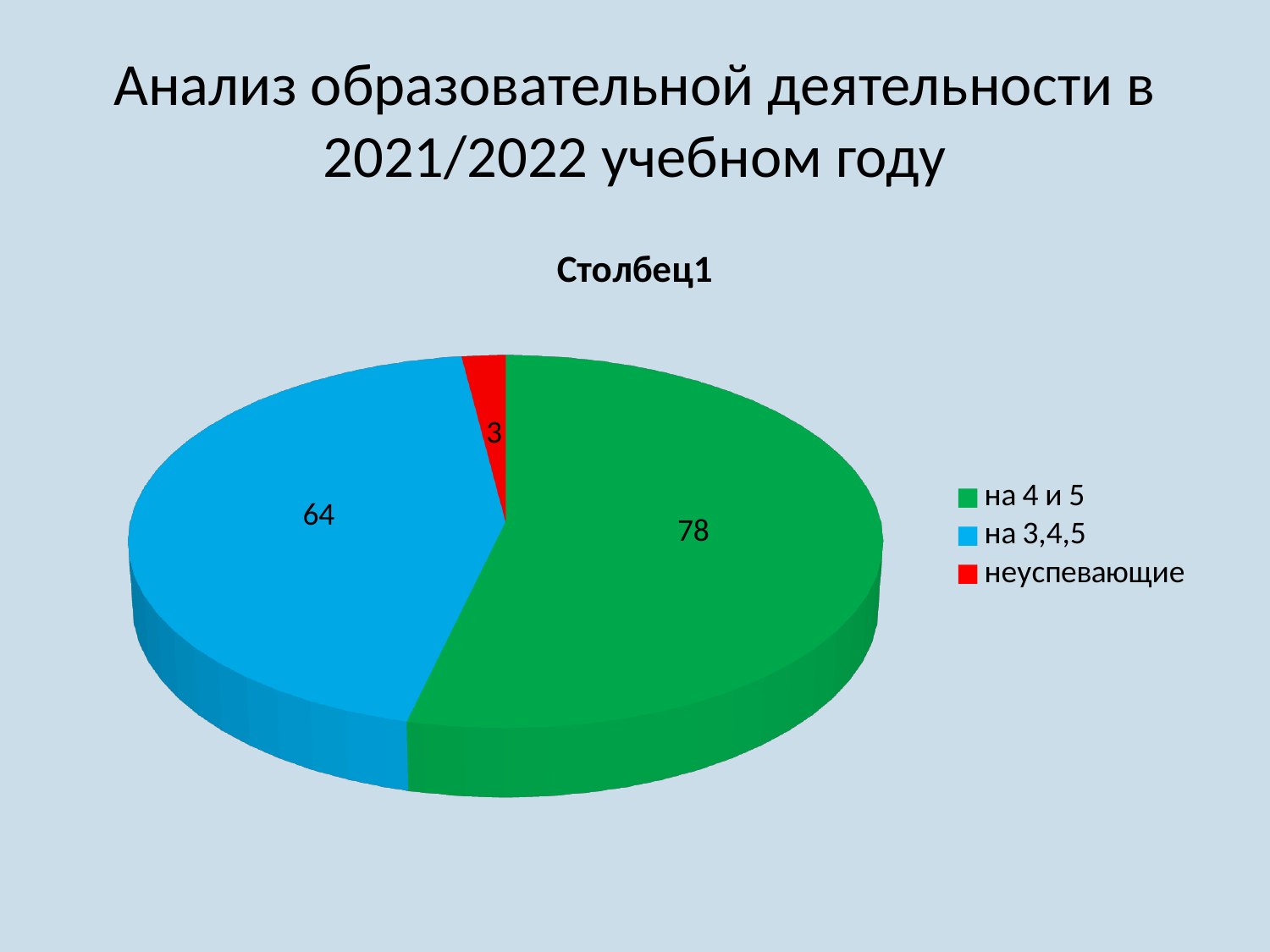
How many slices does the pie chart have? 3 What is the value for "на 3,4,5"? 64 What is the difference between the values for "на 4 и 5" and "на 3,4,5"? 14 What is the title of the chart? Столбец1 What colour is the slice for "неуспевающие"? red How many entries does the legend list? 3 Which category has the smallest slice? неуспевающие Which is larger, the value for "на 3,4,5" or the value for "неуспевающие"? на 3,4,5 What is the value for "на 4 и 5"? 78 Which category has the largest slice? на 4 и 5 What is the value for "неуспевающие"? 3 What kind of chart is shown on the slide? pie chart